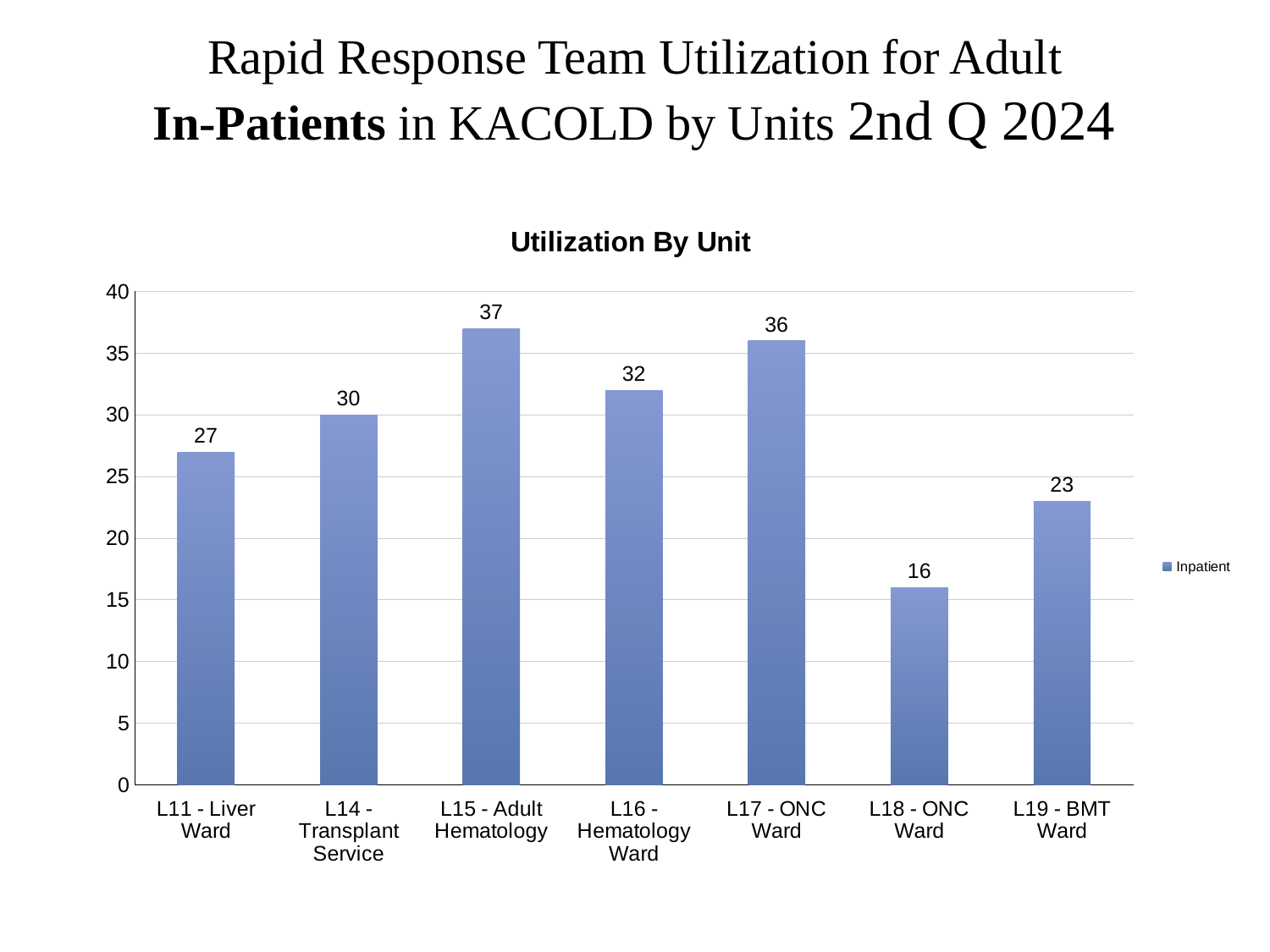
What is the difference between the values for L14 - Transplant Service and L11 - Liver Ward? 3 What is the value for L19 - BMT Ward? 23 Is the value for L17 - ONC Ward greater or less than 35? greater Which unit has the lowest value? L18 - ONC Ward What kind of chart is shown on the slide? Bar chart Which is larger, the value for L16 - Hematology Ward or the value for L19 - BMT Ward? L16 - Hematology Ward What is the value for L18 - ONC Ward? 16 How many series does the legend list? 1 How many units are shown on the x axis? 7 What is the value for L11 - Liver Ward? 27 What is the difference between the values for L15 - Adult Hematology and L18 - ONC Ward? 21 Which unit has the highest value? L15 - Adult Hematology